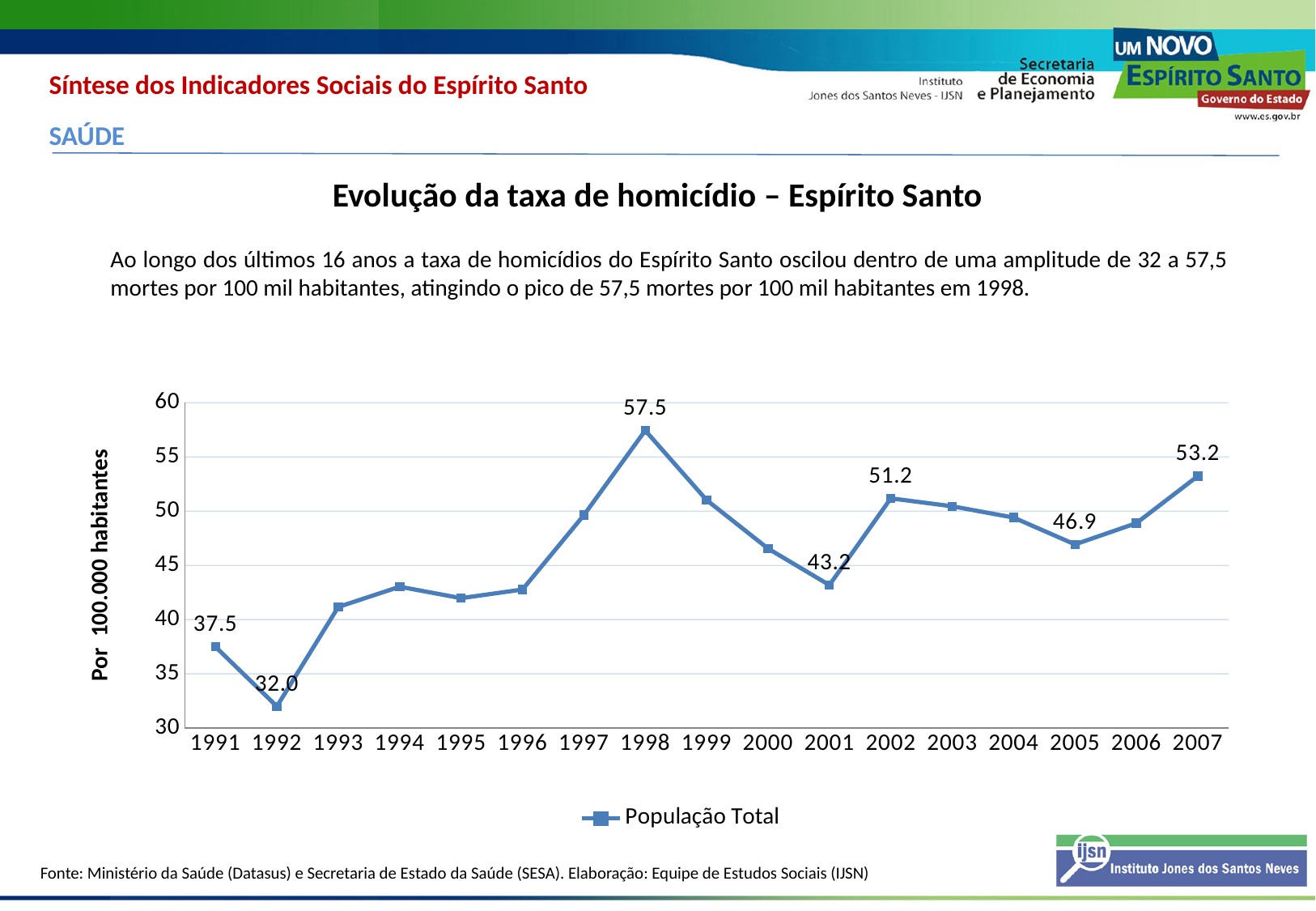
Is the value for 1993 greater or less than 45? less Is the value for 1997 greater or less than 45? greater What is the value plotted for 1992? 32.0 Which year has the lowest homicide rate on the chart? 1992 What is the difference between the values for 2007 and 2005? 6.3 What kind of chart is shown on the slide? Line chart What is the value shown for 2007? 53.2 What is the homicide rate value shown for 1998? 57.5 How many years are plotted on the x axis? 17 What is the difference between the values for 1998 and 1992? 25.5 Which year has the highest homicide rate on the chart? 1998 Which year has the larger value, 2002 or 2007? 2007